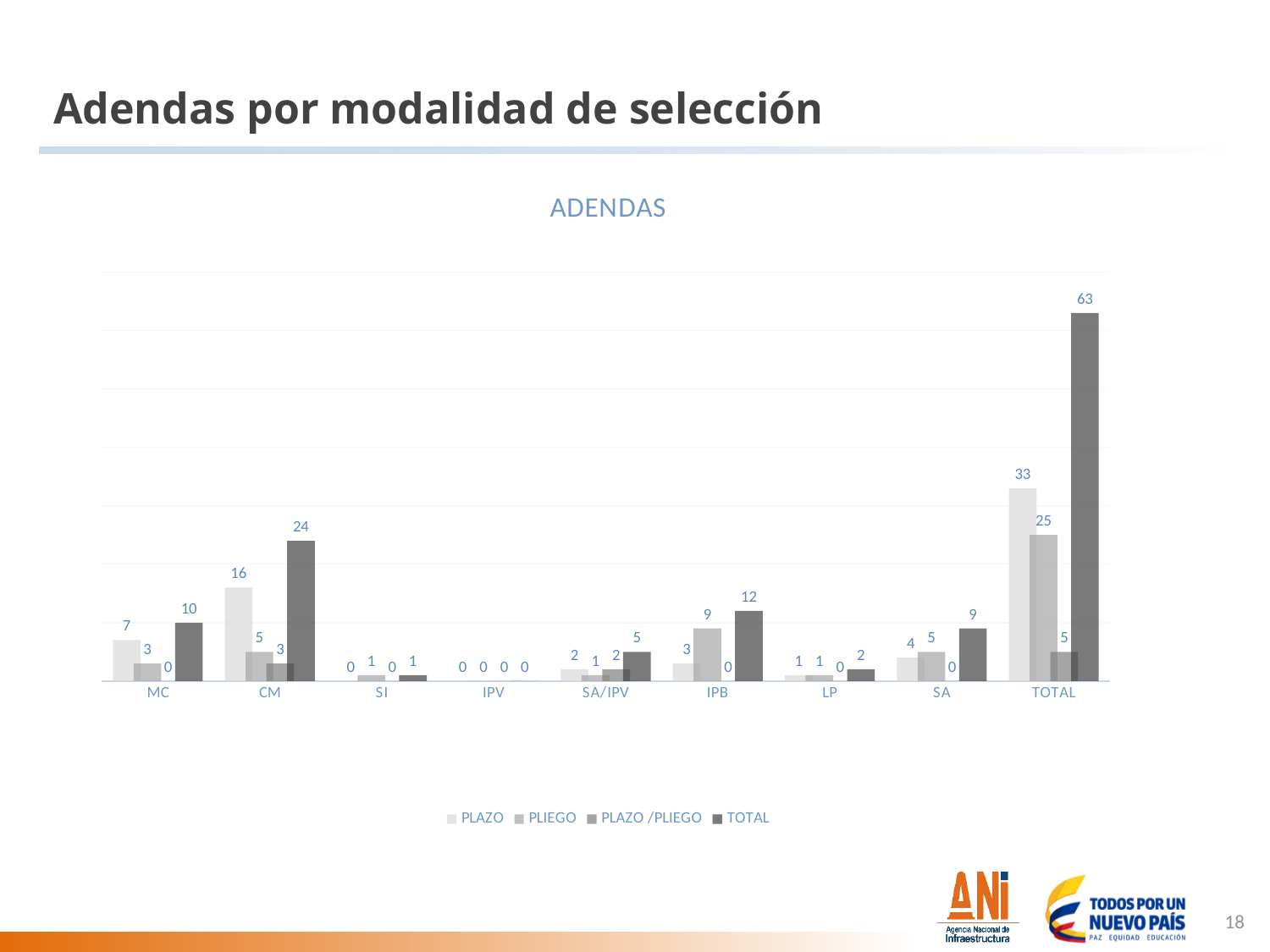
How many series does the legend list? 4 What is the PLAZO value for the MC category? 7 What kind of chart is shown on the slide? Bar chart What is the TOTAL value for the TOTAL category? 63 What is the PLIEGO value for the IPB category? 9 Which category has the lowest TOTAL value? IPV What is the TOTAL value for the CM category? 24 Which is larger, the PLAZO value for CM or the PLAZO value for IPB? PLAZO value for CM What is the title of the chart? ADENDAS Excluding the TOTAL category, which category has the highest TOTAL value? CM What is the difference between the PLAZO and PLIEGO values in the TOTAL category? 8 How many categories are shown on the x axis? 9